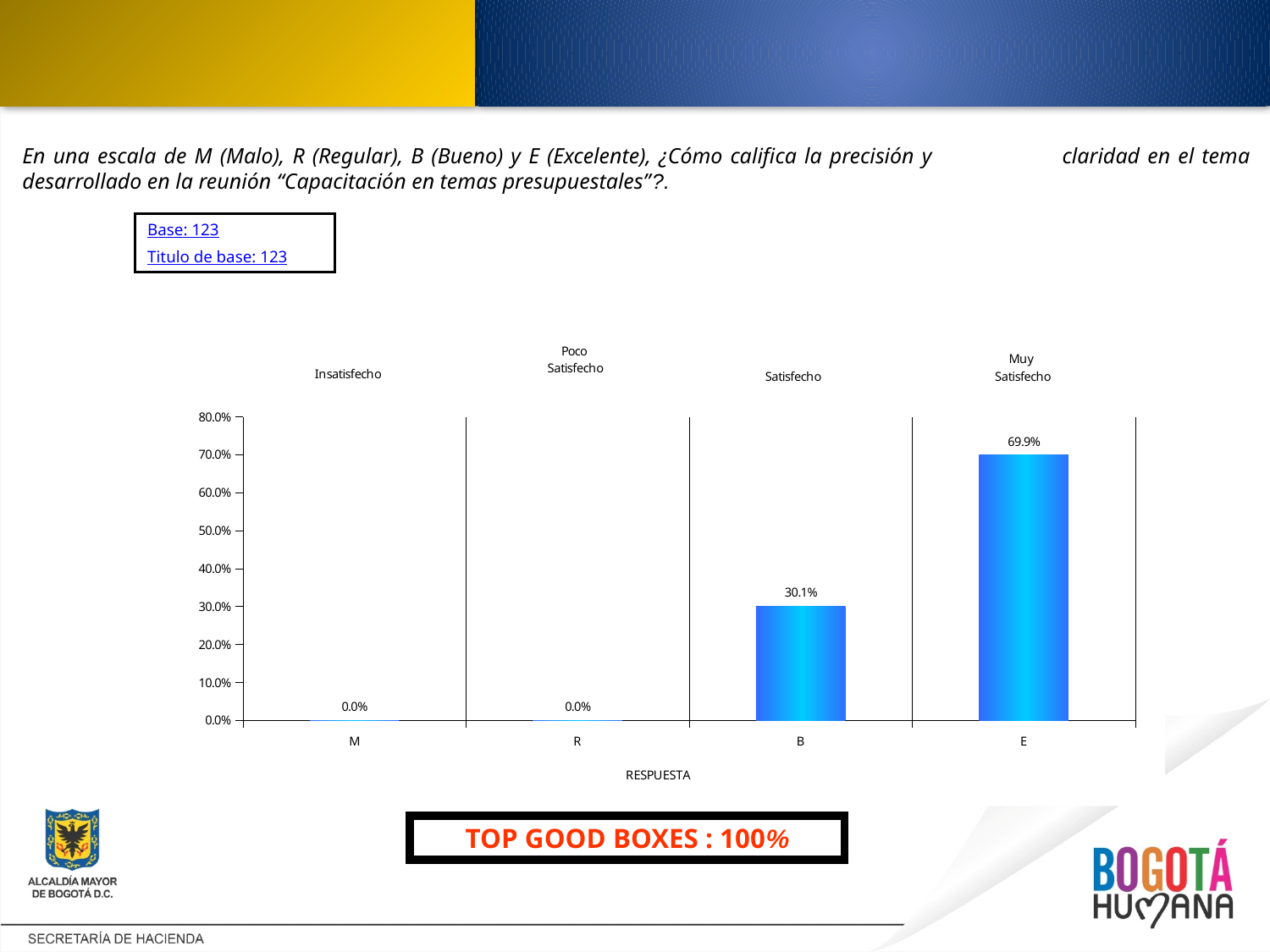
Which category has the highest value? E What is the difference between the values for E and B? 39.8% What is the value for category R (Poco Satisfecho)? 0.0% Which is larger, the value for B or the value for E? E Do the values rise or fall from M to E along the x axis? rise Is the value for E greater or less than 60.0%? greater What kind of chart is shown on the slide? bar chart What is the value for category B (Satisfecho)? 30.1% What is the label of the x axis? RESPUESTA How many categories are shown on the x axis? 4 What is the value for category E (Muy Satisfecho)? 69.9% What is the value for category M (Insatisfecho)? 0.0%